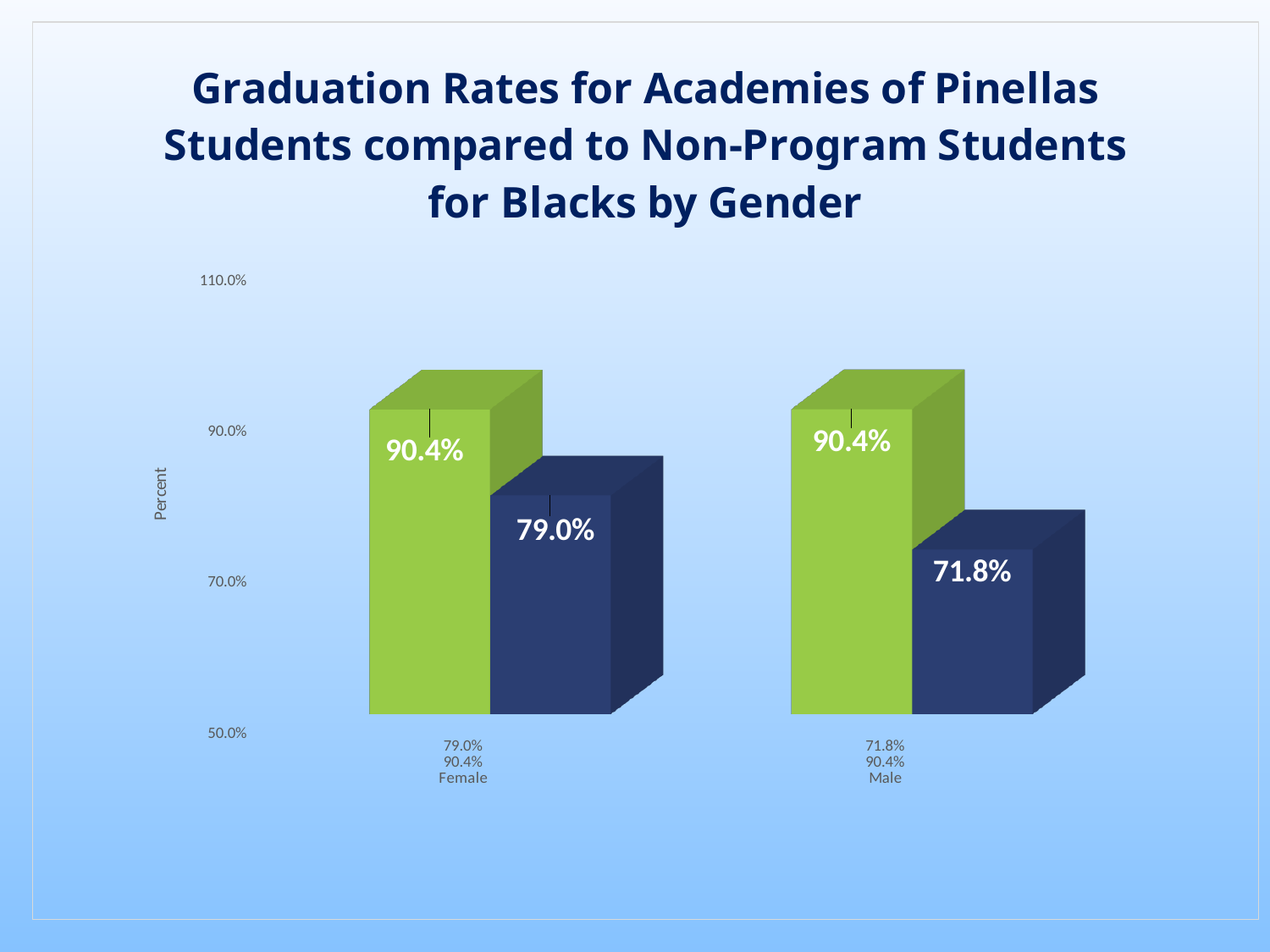
Which bar has the lowest value on the chart? The dark blue bar for Male (71.8%) What is the value of the green bar for Male? 90.4% How many categories are shown on the x axis? 2 What is the label on the vertical axis? Percent What kind of chart is shown on the slide? Bar chart What is the difference between the green bar and the dark blue bar for Female? 11.4% Is the value of the dark blue bar for Male greater or less than 70.0%? greater What is the value of the dark blue bar for Female? 79.0% What is the difference between the green bar and the dark blue bar for Male? 18.6% Which is larger, the dark blue bar for Female or the dark blue bar for Male? Female What is the value of the green bar for Female? 90.4% What is the value of the dark blue bar for Male? 71.8%